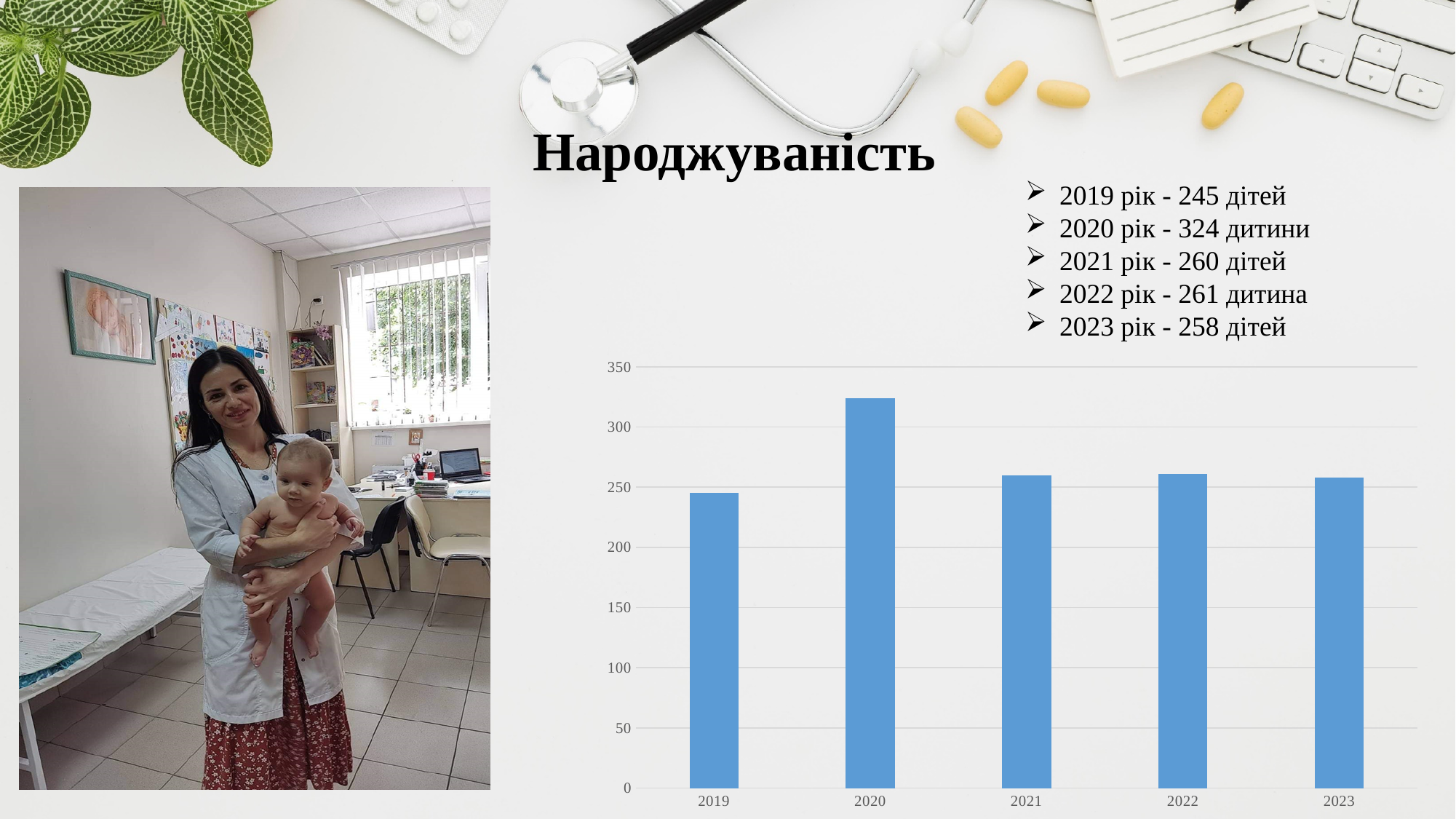
How many years are shown on the x axis of the chart? 5 What is the difference between the values for 2020 and 2019? 79 Which year has the lowest bar in the chart? 2019 Is the value for 2019 greater or less than 250? less Is the value for 2020 greater or less than 300? greater What is the number of children born in 2023 according to the slide? 258 Does the value rise or fall from 2019 to 2020? rise What kind of chart is shown on the slide? bar chart What is the number of children born in 2019 according to the slide? 245 What is the title of the chart? Народжуваність Which year has the highest bar in the chart? 2020 What is the number of children born in 2020 according to the slide? 324